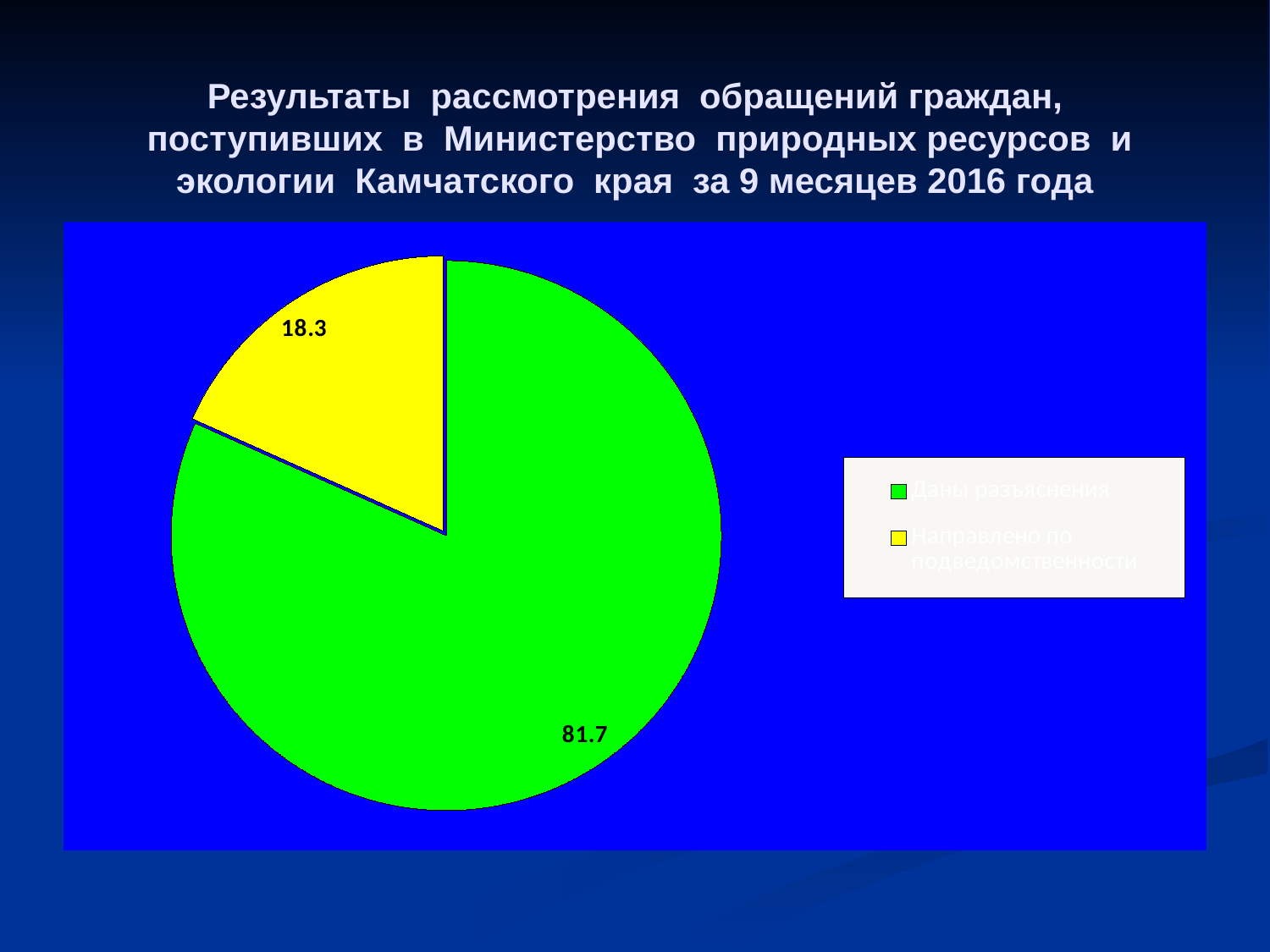
What is the value shown for the green slice (Даны разъяснения)? 81.7 Which category has the largest slice of the pie? Даны разъяснения How many entries does the legend list? 2 Which is larger: the slice for Даны разъяснения or the slice for Направлено по подведомственности? Даны разъяснения What is the total of the two slice values shown on the pie chart? 100 Which category has the smallest slice of the pie? Направлено по подведомственности What kind of chart is shown on the slide? pie chart What colour is the slice labelled Даны разъяснения? green What is the value shown for the yellow slice (Направлено по подведомственности)? 18.3 What is the difference between the values of the two slices (81.7 and 18.3)? 63.4 What colour is the slice labelled Направлено по подведомственности? yellow How many slices does the pie chart have? 2